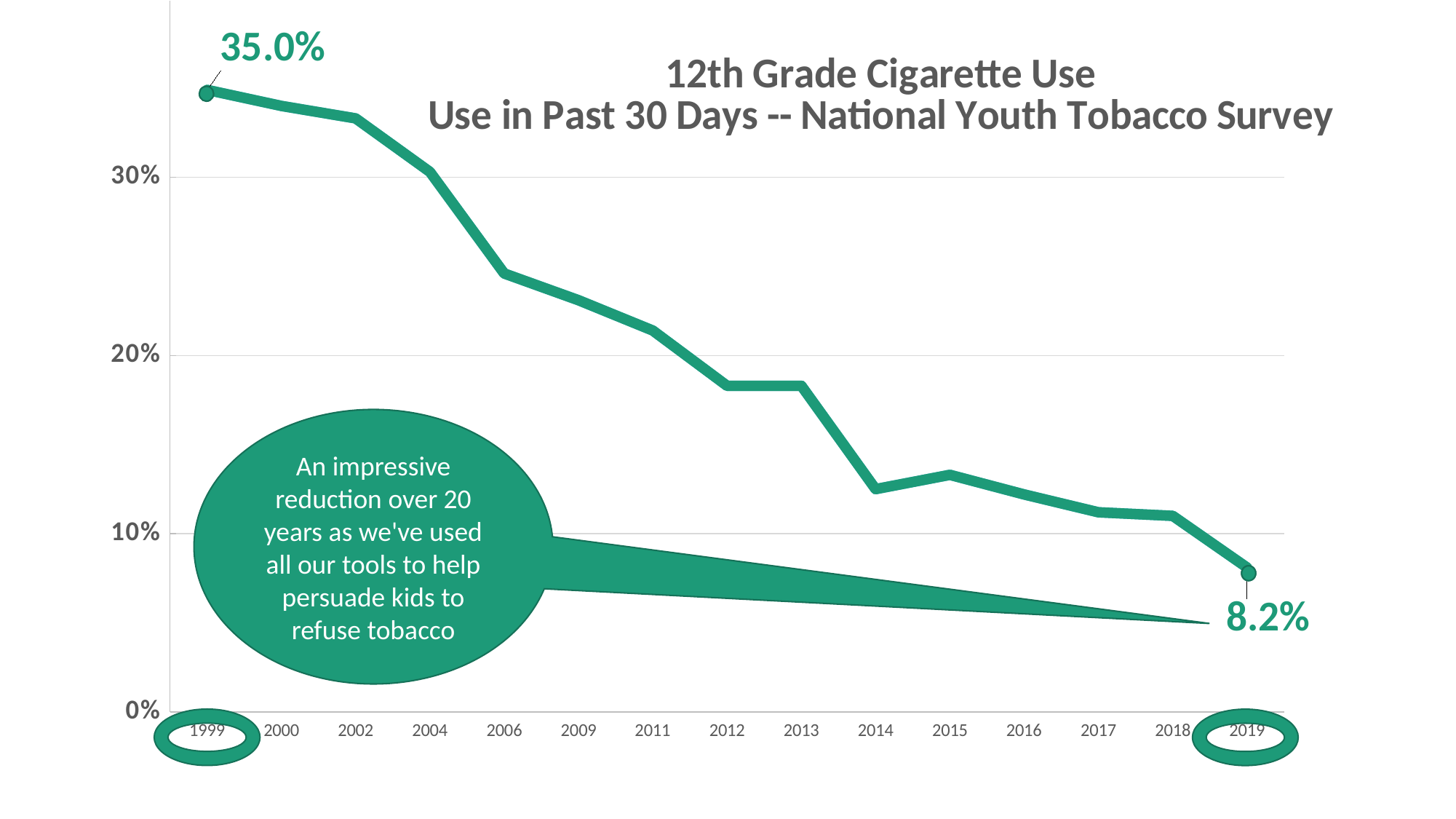
What is the difference between the 1999 value and the 2019 value? 26.8 percentage points Is the value for 2012 greater or less than 20%? less Is the value for 2006 greater or less than 20%? greater Do the values rise or fall from 1999 to 2019? fall What is the 12th grade cigarette use value for 1999? 35.0% What is the 12th grade cigarette use value for 2019? 8.2% What type of chart is shown on the slide? line chart Which year has the highest cigarette use value? 1999 Is the value for 2002 greater or less than 30%? greater Which is larger, the value for 2006 or the value for 2014? 2006 Which year has the lowest cigarette use value? 2019 How many years are plotted on the x axis? 15